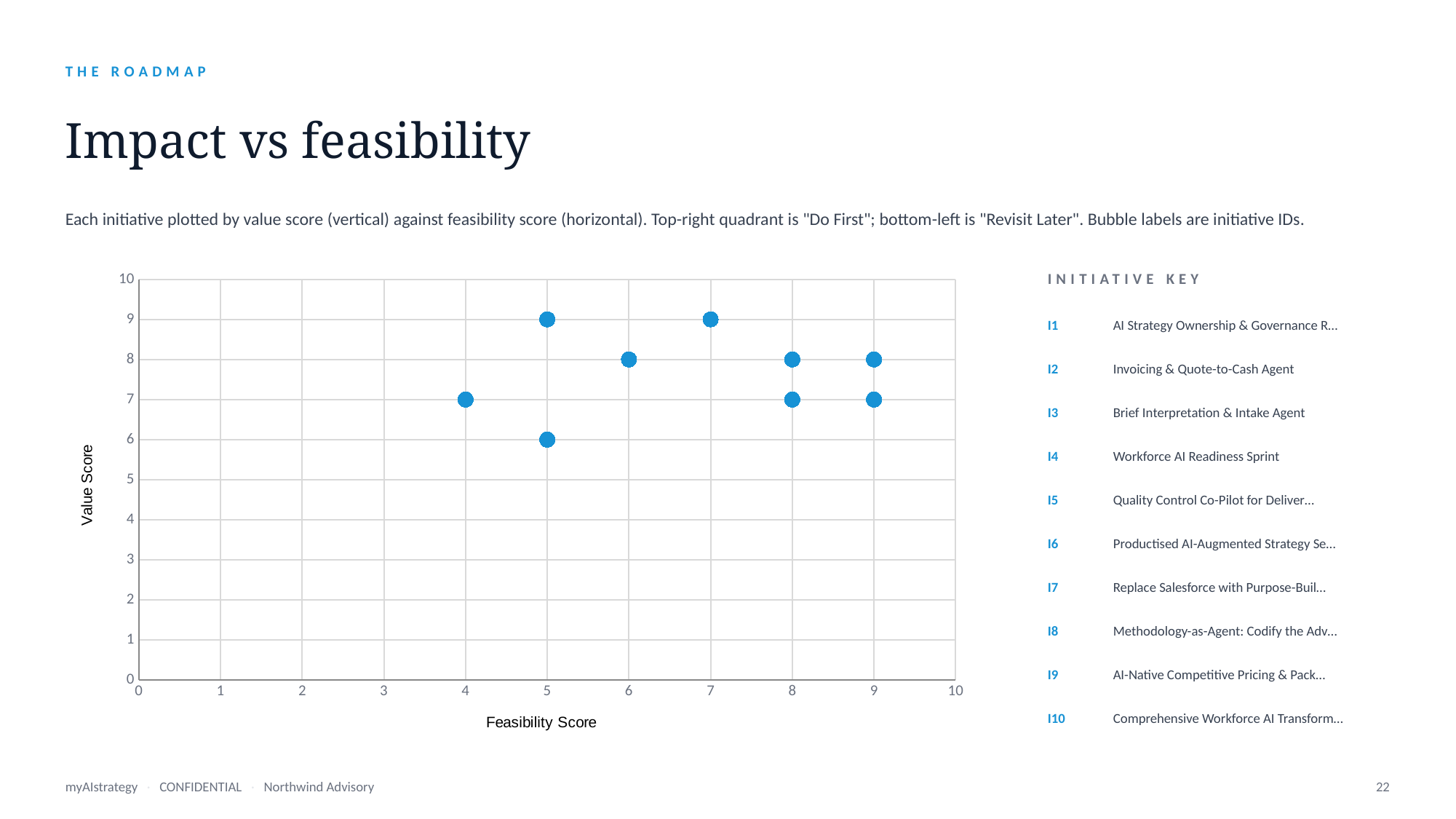
What kind of chart is shown on the slide? Scatter chart How many initiatives are listed in the Initiative Key beside the chart? 10 What is the highest feasibility score of any point on the chart? 9 What is the lowest feasibility score of any point on the chart? 4 What is the value score of the point plotted at a feasibility score of 4? 7 What is the highest value score reached by any point on the chart? 9 What is the value score of the point plotted at a feasibility score of 6? 8 How many points are plotted at a feasibility score of 5? 2 What is the title of the vertical axis of the chart? Value Score What is the value score of the point plotted at a feasibility score of 7? 9 What is the title of the horizontal axis of the chart? Feasibility Score What is the lowest value score of any point on the chart? 6